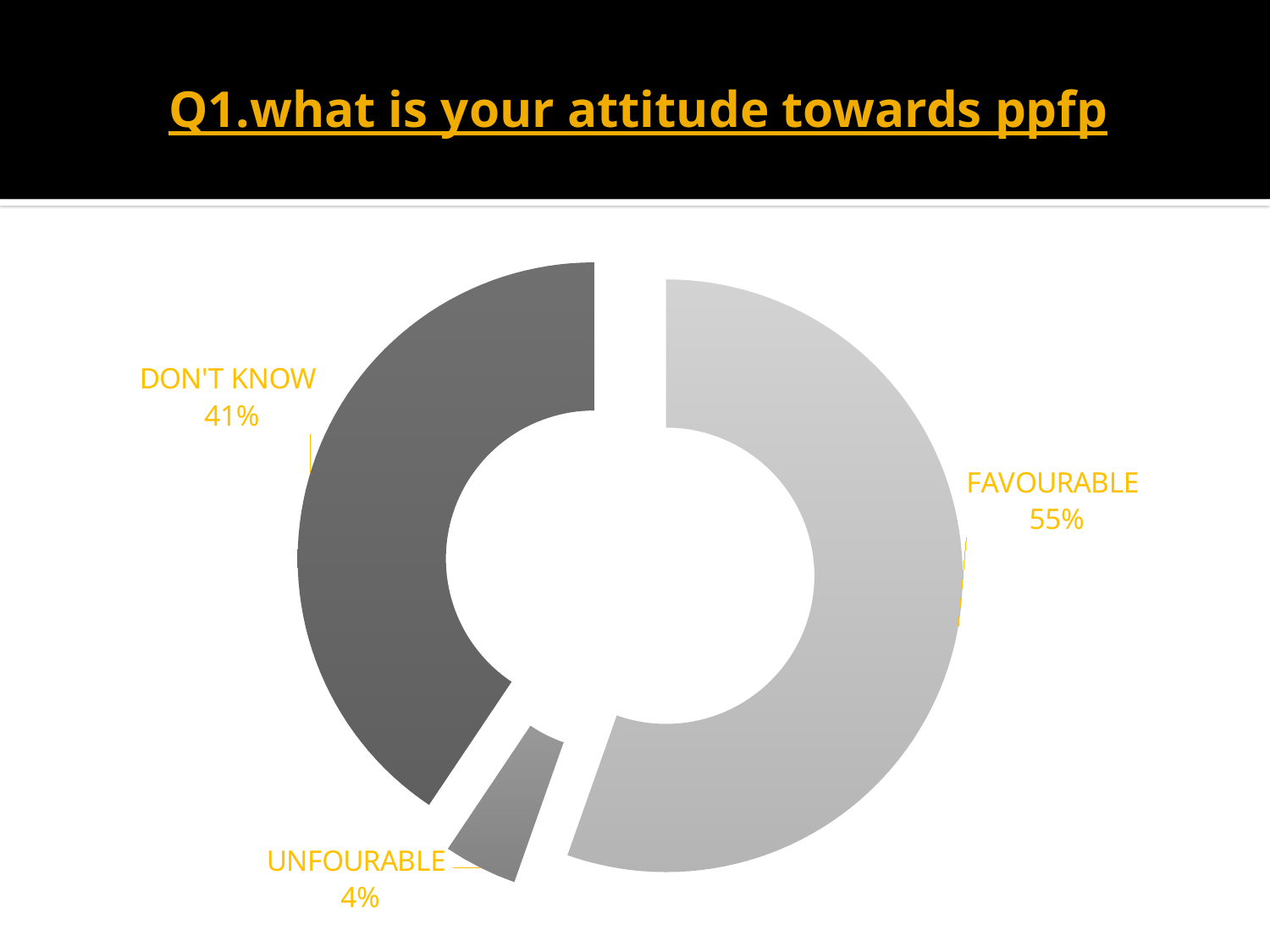
Which category has the largest share of the chart? FAVOURABLE What share of the chart does the UNFOURABLE slice represent? 4% How many categories are shown in the chart? 3 What percentage of respondents answered DON'T KNOW? 41% What is the difference in percentage points between FAVOURABLE and DON'T KNOW? 14 What percentage of respondents answered FAVOURABLE? 55% Which is larger, the share for FAVOURABLE or the share for DON'T KNOW? FAVOURABLE What percentage of respondents answered UNFOURABLE? 4% What kind of chart is shown on the slide? Doughnut (pie) chart What is the difference in percentage points between DON'T KNOW and UNFOURABLE? 37 What is the title of the slide? Q1.what is your attitude towards ppfp Which category has the smallest share of the chart? UNFOURABLE